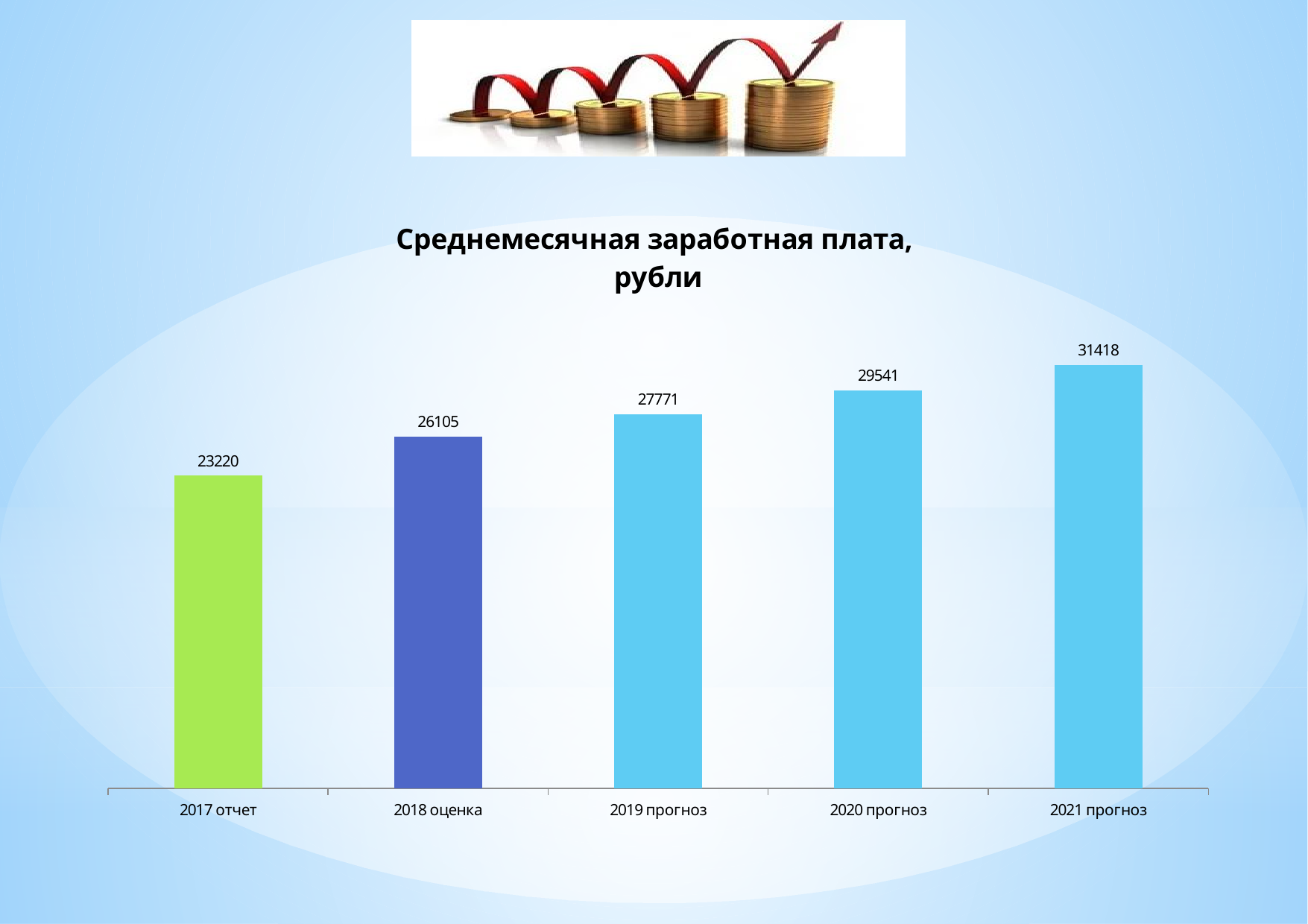
What is the difference between the values for 2018 оценка and 2017 отчет? 2885 What is the title of the chart? Среднемесячная заработная плата, рубли Do the values rise or fall from 2017 отчет to 2021 прогноз? rise Which category has the highest value? 2021 прогноз Which category has the lowest value? 2017 отчет What is the value for 2019 прогноз? 27771 What is the value for 2017 отчет? 23220 What kind of chart is this? bar chart Which is larger, the value for 2018 оценка or the value for 2019 прогноз? 2019 прогноз What is the value for 2021 прогноз? 31418 How many categories are shown on the x axis? 5 What is the difference between the values for 2021 прогноз and 2020 прогноз? 1877